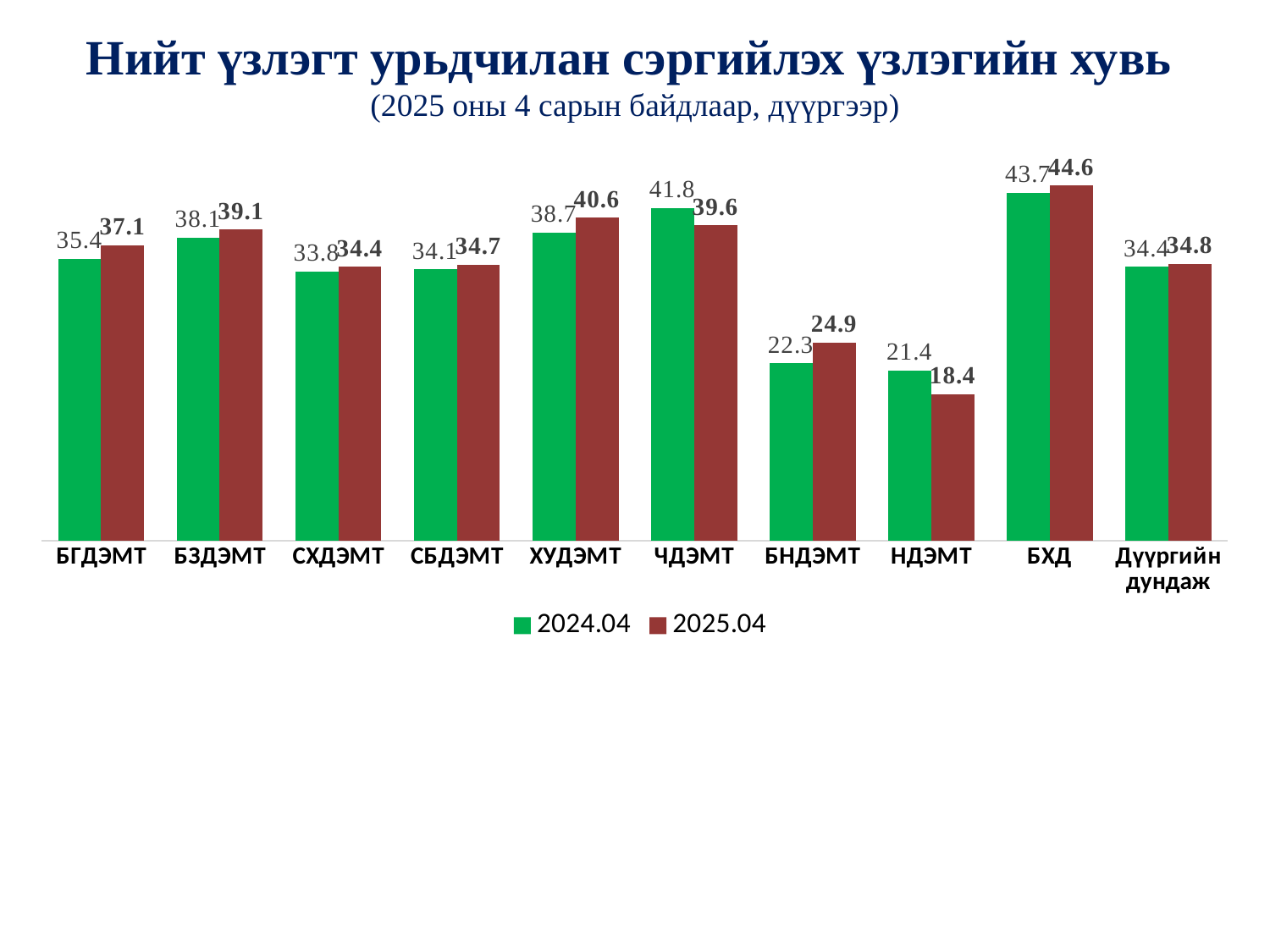
How many categories are shown on the x axis? 10 For ЧДЭМТ, which is larger: the 2024.04 value or the 2025.04 value? 2024.04 What kind of chart is shown on the slide? Bar chart What is the 2025.04 value for Дүүргийн дундаж? 34.8 How many series does the legend list? 2 What is the 2025.04 value for БНДЭМТ? 24.9 Which category has the lowest 2025.04 value? НДЭМТ What is the 2024.04 value for НДЭМТ? 21.4 What is the difference between the 2025.04 and 2024.04 values for ХУДЭМТ? 1.9 For НДЭМТ, which is larger: the 2024.04 value or the 2025.04 value? 2024.04 Which category has the highest 2025.04 value? БХД What is the 2025.04 value for БХД? 44.6